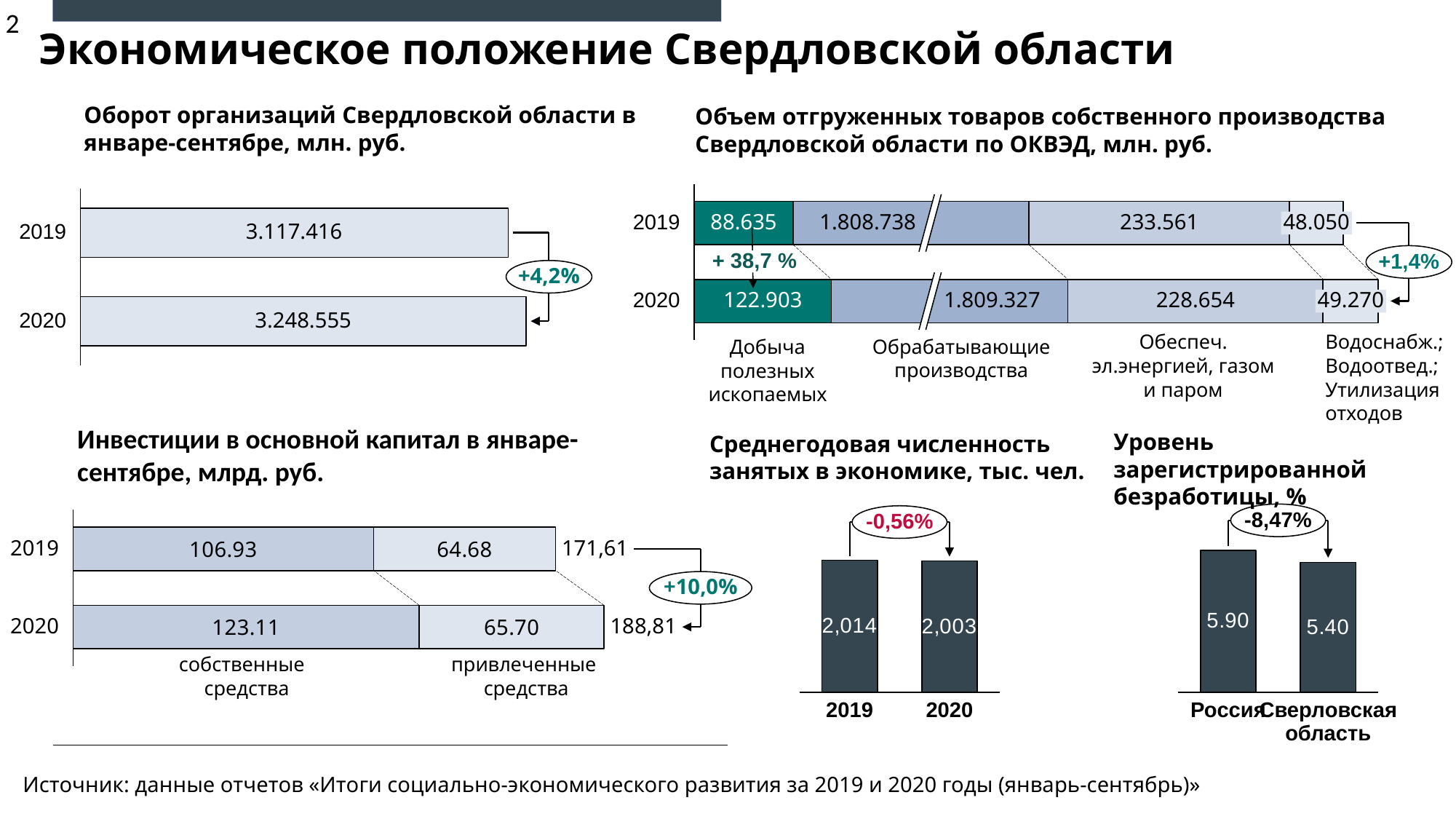
In the chart 'Инвестиции в основной капитал в январе-сентябре, млрд. руб.', what is the total for 2019? 171,61 In the chart 'Среднегодовая численность занятых в экономике, тыс. чел.', what is the value for 2019? 2,014 In the chart 'Объем отгруженных товаров собственного производства Свердловской области по ОКВЭД, млн. руб.', what is the value for 'Обеспеч. эл.энергией, газом и паром' in 2019? 233.561 In the chart 'Оборот организаций Свердловской области в январе-сентябре, млн. руб.', which year has the higher value, 2019 or 2020? 2020 In the chart 'Объем отгруженных товаров собственного производства Свердловской области по ОКВЭД, млн. руб.', what is the value for 'Добыча полезных ископаемых' in 2020? 122.903 In the chart 'Объем отгруженных товаров собственного производства Свердловской области по ОКВЭД, млн. руб.', which category has the largest value in 2020? Обрабатывающие производства In the chart 'Уровень зарегистрированной безработицы, %', which has the lower value, Россия or Свердловская область? Свердловская область In the chart 'Объем отгруженных товаров собственного производства Свердловской области по ОКВЭД, млн. руб.', how many categories are shown for each year? 4 In the chart 'Инвестиции в основной капитал в январе-сентябре, млрд. руб.', what is the value of 'собственные средства' in 2020? 123.11 In the chart 'Оборот организаций Свердловской области в январе-сентябре, млн. руб.', what is the value for 2020? 3.248.555 In the chart 'Инвестиции в основной капитал в январе-сентябре, млрд. руб.', what is the difference between 'собственные средства' and 'привлеченные средства' in 2019? 42.25 What kind of chart is 'Уровень зарегистрированной безработицы, %'? Bar chart